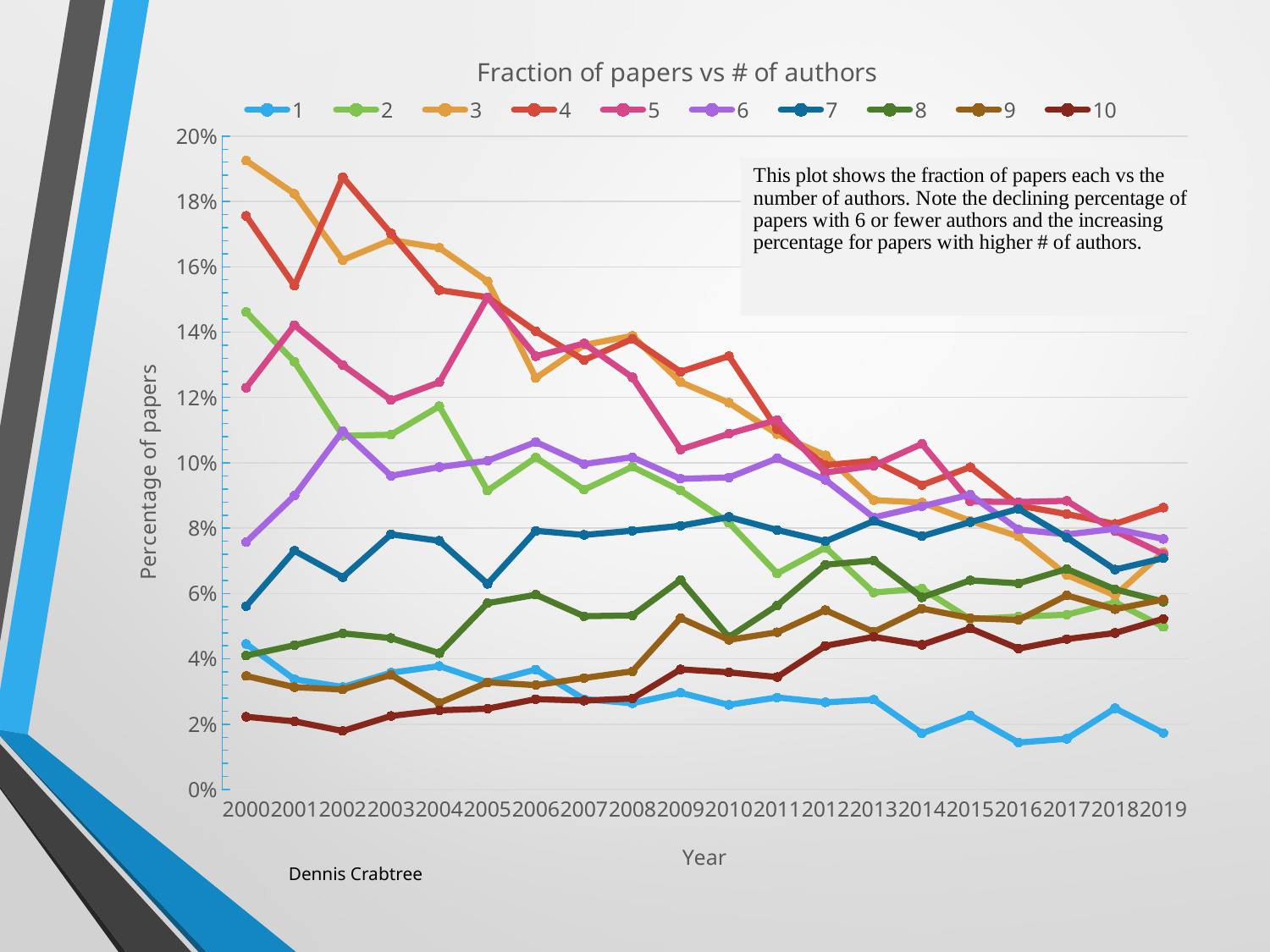
How many years are plotted along the x axis? 20 Which series has the lowest value in 2000? 10 Does the value for series 10 rise or fall from 2000 to 2019? rise Is the value for series 1 in 2019 greater or less than 2%? less What kind of chart is shown on the slide? line chart Does the value for series 1 rise or fall from 2000 to 2019? fall What is the label on the y axis? Percentage of papers Which series has the highest value in 2000? 3 Is the value for series 3 in 2000 greater or less than 18%? greater Is the value for series 2 in 2000 greater or less than 14%? greater How many series does the legend list? 10 What is the title of the chart? Fraction of papers vs # of authors